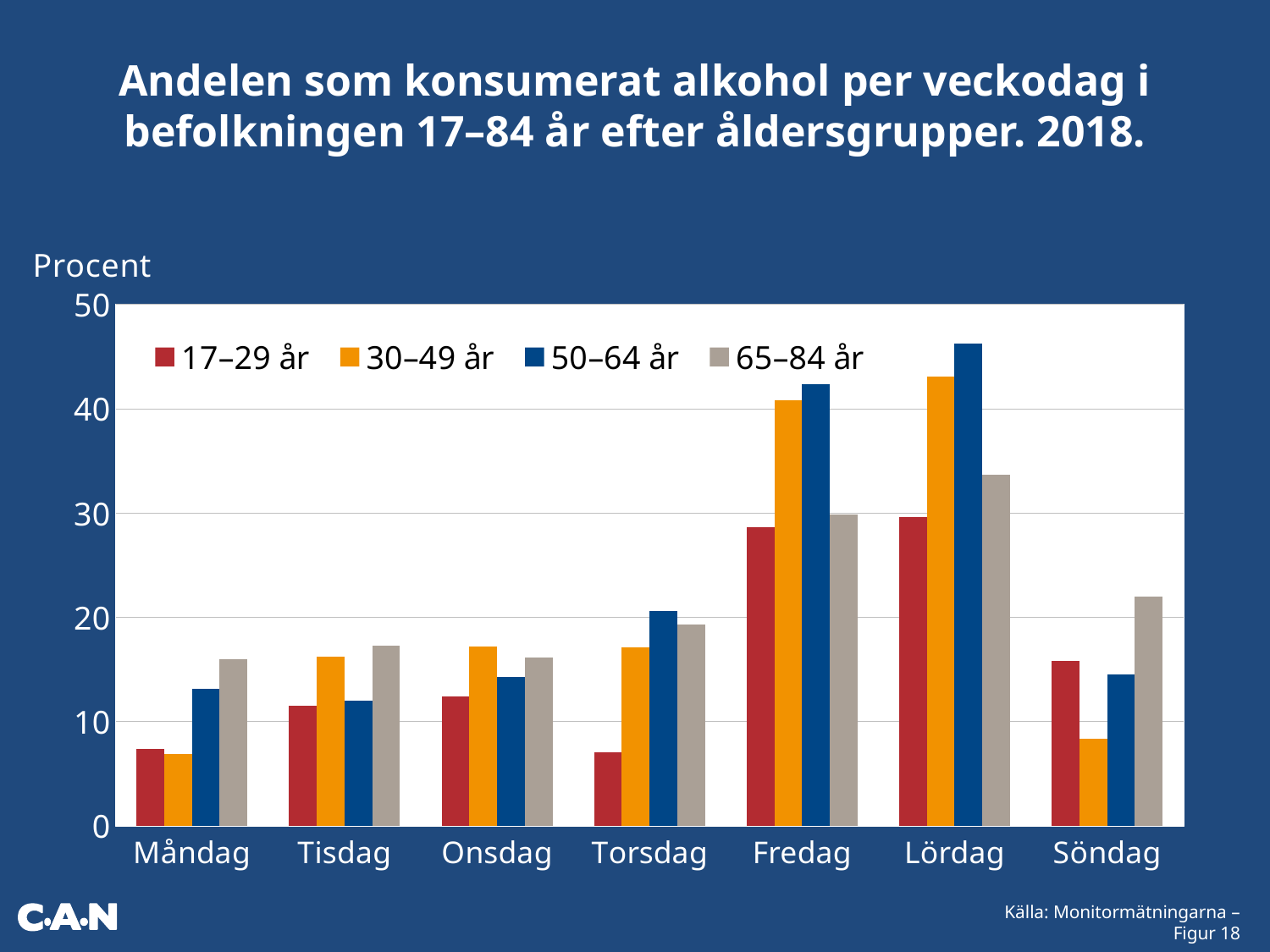
How many age groups does the legend list? 4 On which day is the value for 50–64 år highest? Lördag On Torsdag, which is larger: the value for 17–29 år or for 30–49 år? 30–49 år What type of chart is shown on the slide? bar chart How many weekdays are shown on the x axis? 7 Which age group has the highest value on Söndag? 65–84 år What is the label on the vertical axis? Procent Is the value for 65–84 år on Söndag greater or less than 20? greater On Söndag, which is larger: the value for 65–84 år or for 17–29 år? 65–84 år Is the value for 17–29 år on Måndag greater or less than 10? less Which age group has the highest value on Lördag? 50–64 år Is the value for 30–49 år on Fredag greater or less than 40? greater